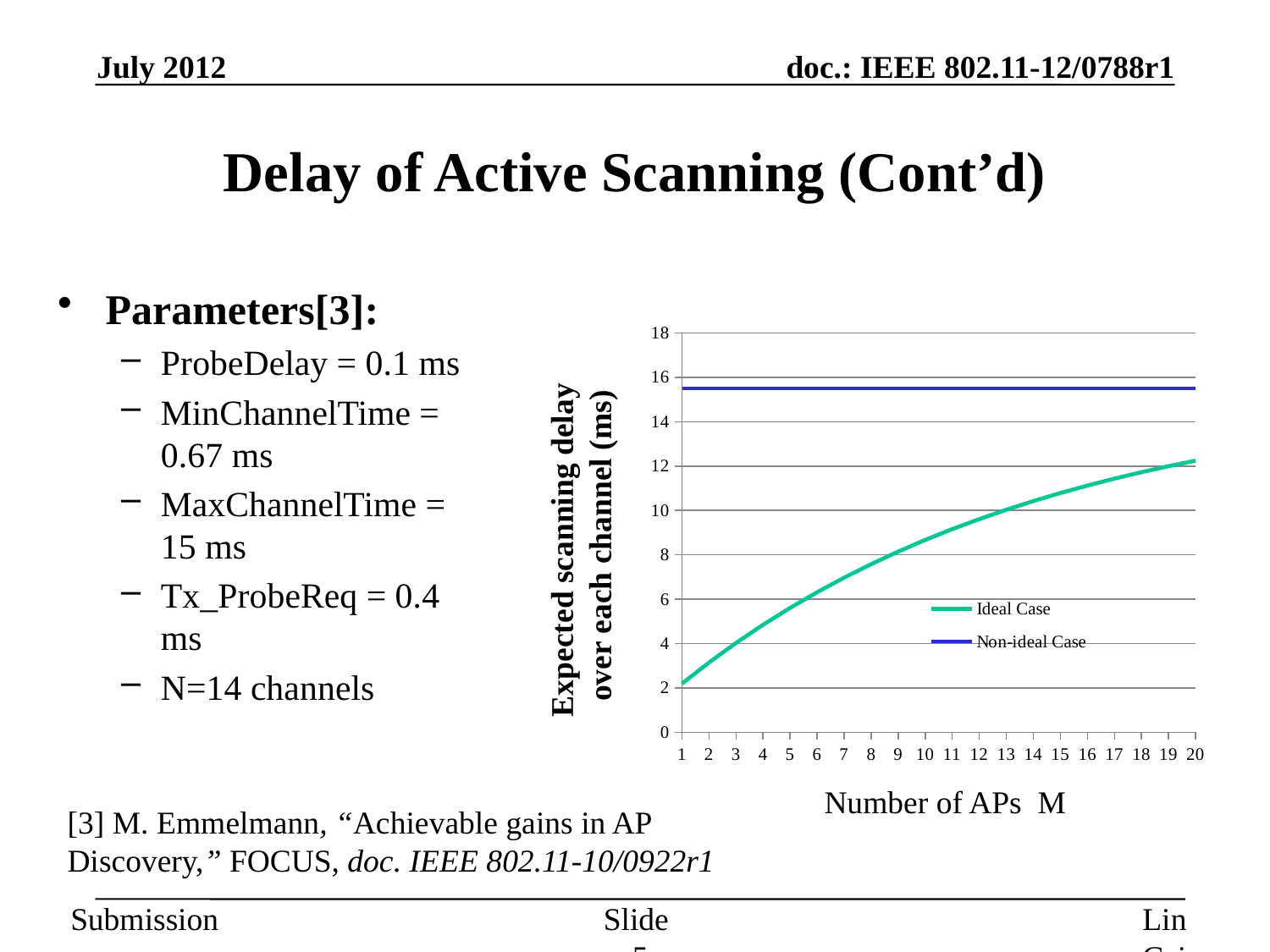
How many series does the chart legend list? 2 What are the two series named in the legend? Ideal Case and Non-ideal Case What is the label of the y axis? Expected scanning delay over each channel (ms) Does the Non-ideal Case series rise, fall, or stay flat as the number of APs M increases? stay flat Is the Ideal Case value at M=20 greater or less than 10? greater Is the Ideal Case value at M=1 greater or less than 4? less What kind of chart is shown on the slide? line chart Is the Non-ideal Case value greater or less than 14? greater At M=10, which series has the higher expected scanning delay, Ideal Case or Non-ideal Case? Non-ideal Case Does the Ideal Case series rise or fall as the number of APs M increases? rise How many values of M (number of APs) are shown along the x axis? 20